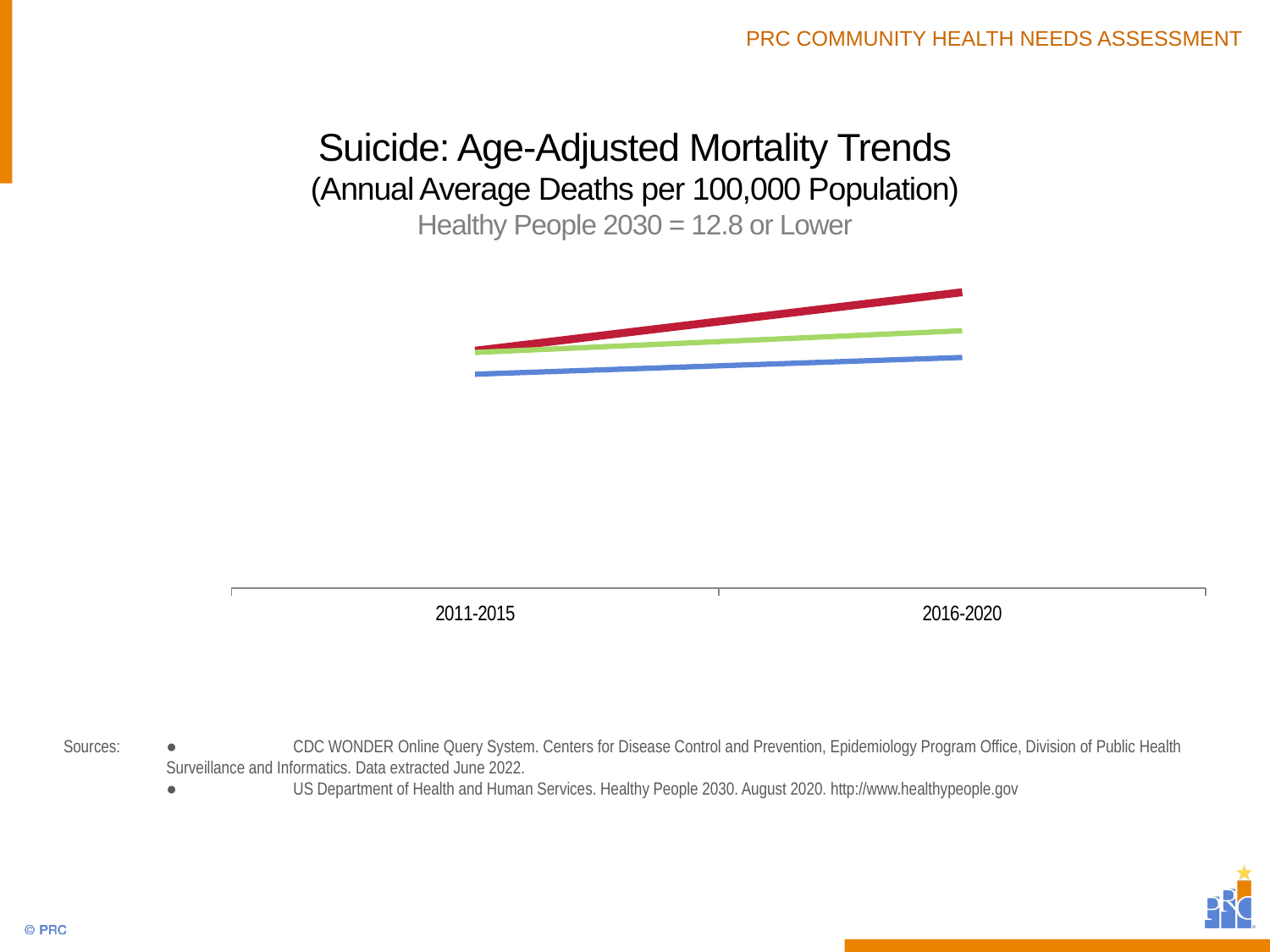
Which coloured line is highest at 2016-2020? red What is the Healthy People 2030 target stated in the chart title? 12.8 or Lower Does the red line rise or fall from 2011-2015 to 2016-2020? rise How many time periods are shown on the x axis of the chart? 2 What kind of chart is shown on the slide? line chart Does the blue line rise or fall from 2011-2015 to 2016-2020? rise What are the two time periods labelled on the x axis? 2011-2015 and 2016-2020 Which coloured line is lowest at 2016-2020? blue At 2016-2020, is the red line or the blue line higher? red Which line shows the steepest increase between 2011-2015 and 2016-2020? red How many lines are plotted on the chart? 3